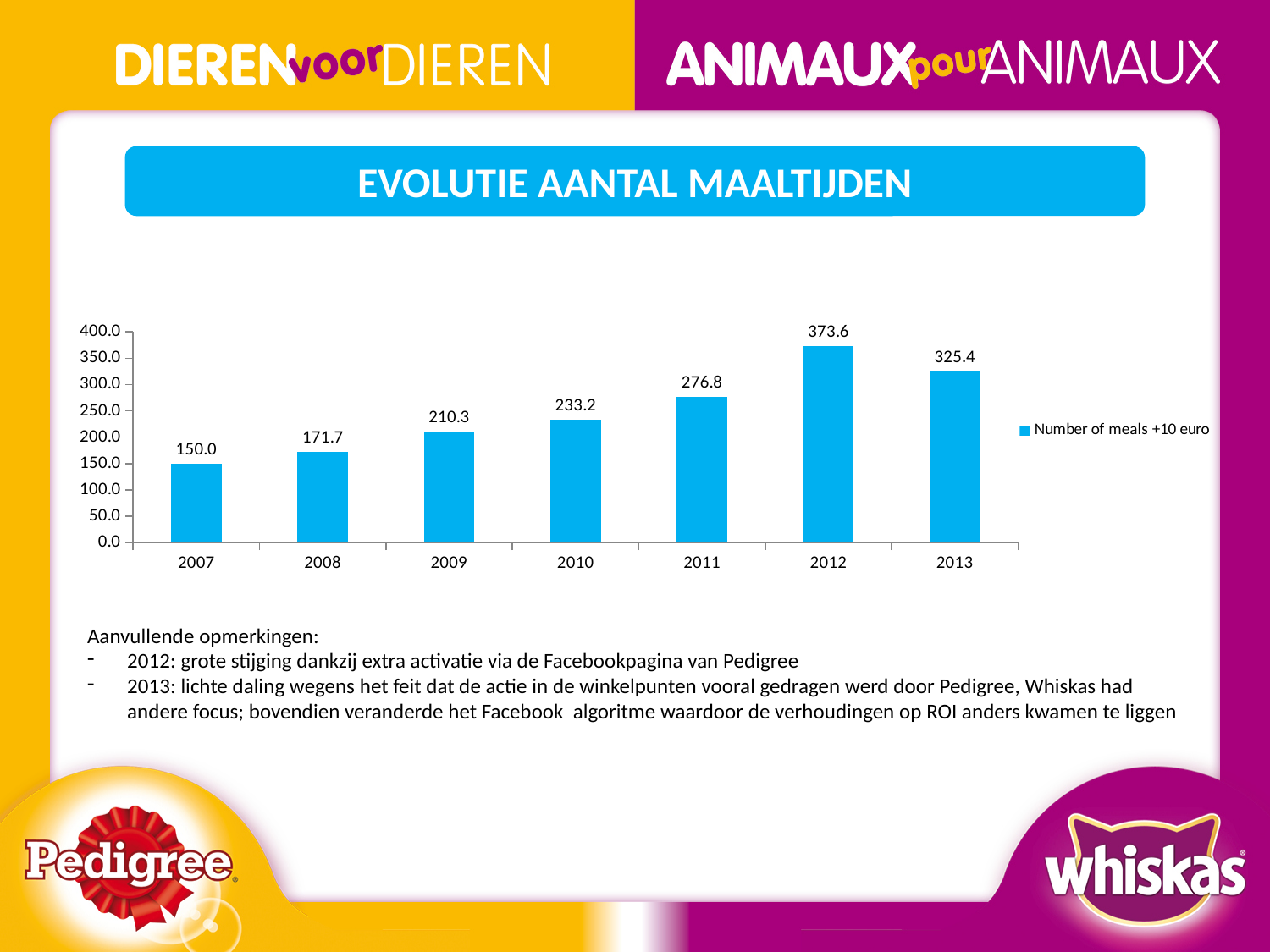
What is the value for 2010? 233.2 Which year has the highest value? 2012 Is the value for 2009 greater or less than 200.0? greater What is the difference between the values for 2012 and 2013? 48.2 What is the value for 2012? 373.6 What kind of chart is shown on the slide? bar chart What is the difference between the values for 2008 and 2007? 21.7 Which year has the lowest value? 2007 Which is larger, the value for 2011 or the value for 2013? 2013 What is the legend entry for the series shown? Number of meals +10 euro What is the value for 2007? 150.0 How many years are shown on the x axis? 7